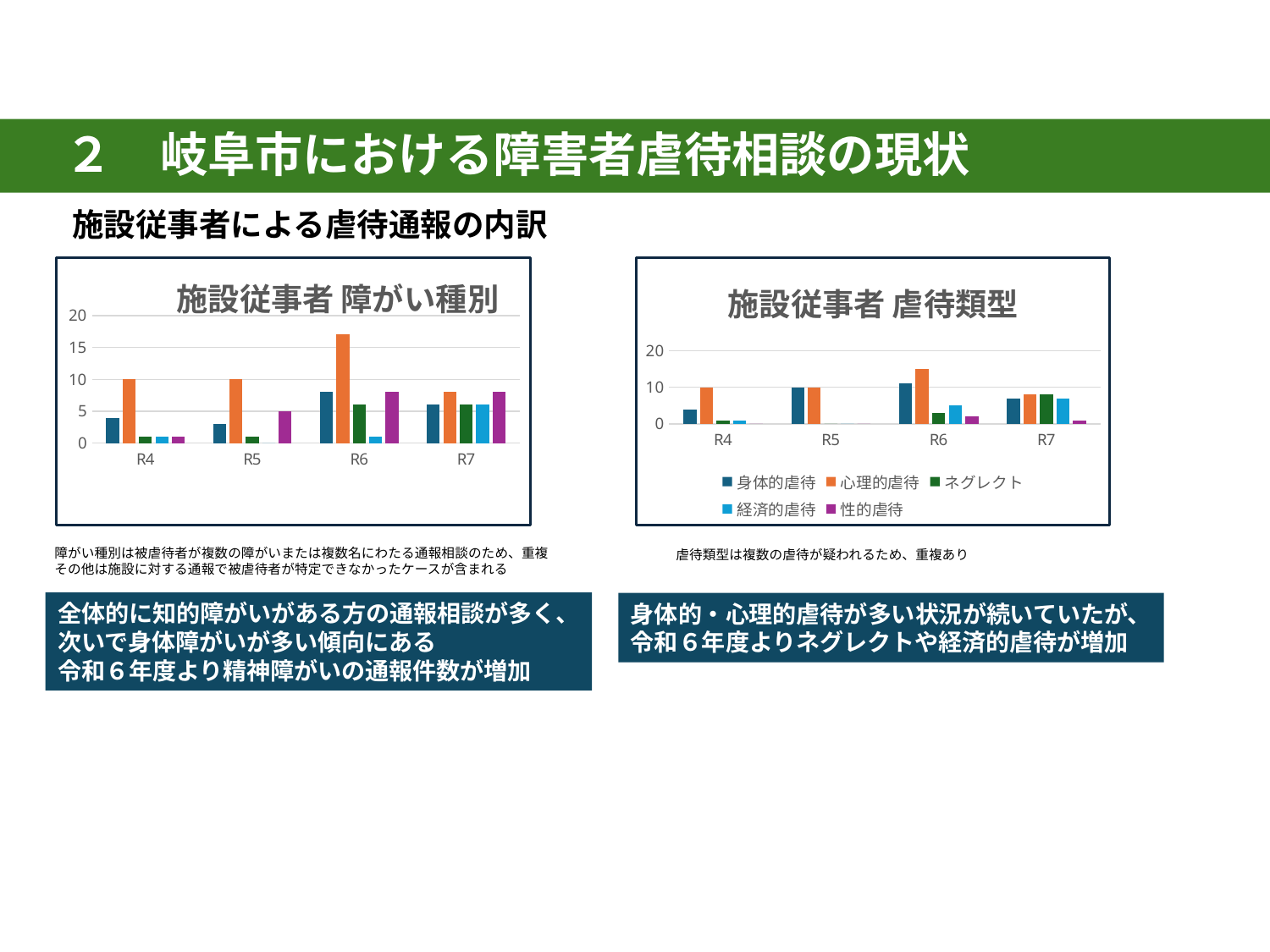
How many series does the legend of the chart titled 施設従事者 虐待類型 list? 5 In the chart titled 施設従事者 障がい種別, is the tallest bar in R6 greater or less than 15? greater In the chart titled 施設従事者 虐待類型, which is larger in R6: 身体的虐待 or ネグレクト? 身体的虐待 In the chart titled 施設従事者 障がい種別, which category has the tallest bar overall? R6 In the chart titled 施設従事者 虐待類型, is the value for 身体的虐待 in R4 greater or less than 10? less How many categories are shown on the x axis of the chart titled 施設従事者 虐待類型? 4 In the chart titled 施設従事者 障がい種別, is the purple bar in R4 greater or less than 5? less What is the title of the chart on the right side of the slide? 施設従事者 虐待類型 In the chart titled 施設従事者 虐待類型, which category has the highest 心理的虐待 bar? R6 In the chart titled 施設従事者 虐待類型, which series is shown in purple according to the legend? 性的虐待 What kind of chart is the chart titled 施設従事者 障がい種別? bar chart